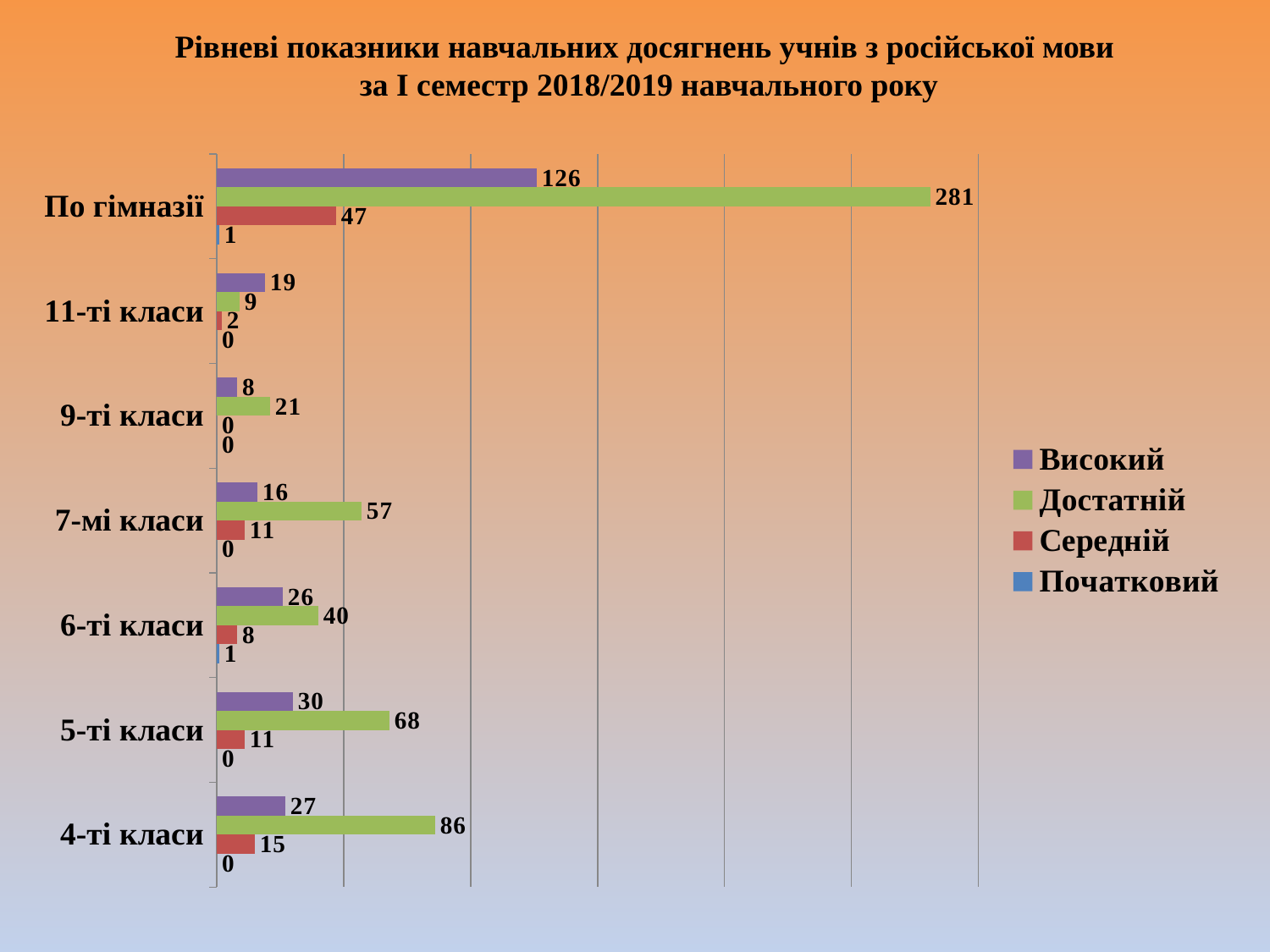
How many series does the legend list? 4 Which colour represents the Середній series in the legend? Red Which class group has the highest Достатній value, excluding По гімназії? 4-ті класи How many categories are shown on the vertical axis? 7 What kind of chart is shown on the slide? Bar chart What is the value of Високий for 5-ті класи? 30 What is the value of Середній for 4-ті класи? 15 What is the value of Достатній for По гімназії? 281 Which class group has the lowest Високий value? 9-ті класи Which is larger for 6-ті класи: Високий or Достатній? Достатній What is the value of Початковий for 6-ті класи? 1 What is the difference between the Достатній and Високий values for 7-мі класи? 41